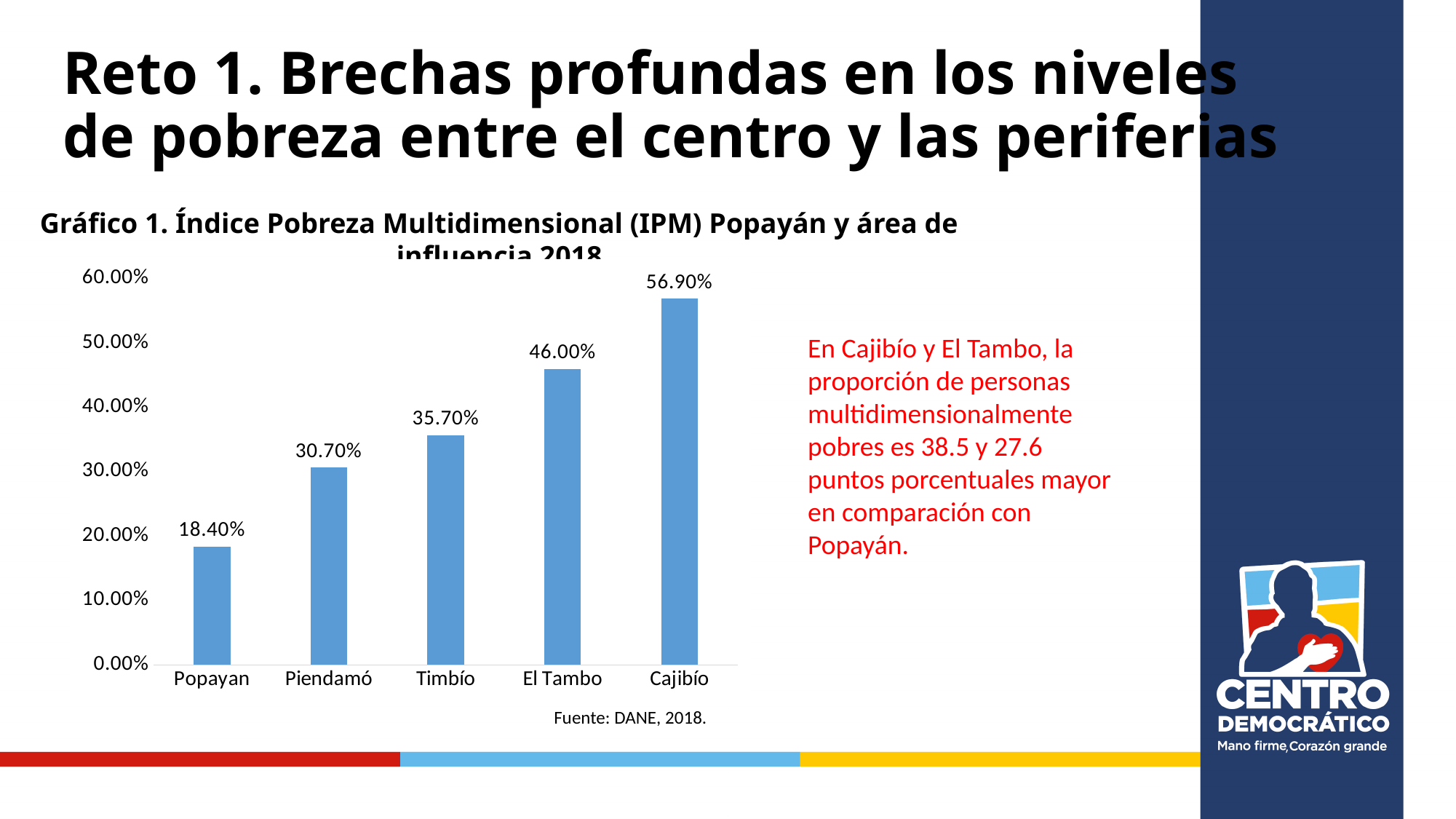
What is the IPM value for Popayan? 18.40% What is the difference between the IPM values of El Tambo and Piendamó? 15.30% What is the IPM value for Timbío? 35.70% Which has a higher IPM value, Piendamó or Timbío? Timbío Do the IPM values rise or fall from left to right across the x axis? Rise How many municipalities are shown in the chart? 5 What is the difference between the IPM values of Cajibío and Popayan? 38.50% Which municipality has the lowest IPM value? Popayan What is the IPM value for El Tambo? 46.00% What is the IPM value for Cajibío? 56.90% What type of chart is shown on the slide? Bar chart Which municipality has the highest IPM value? Cajibío